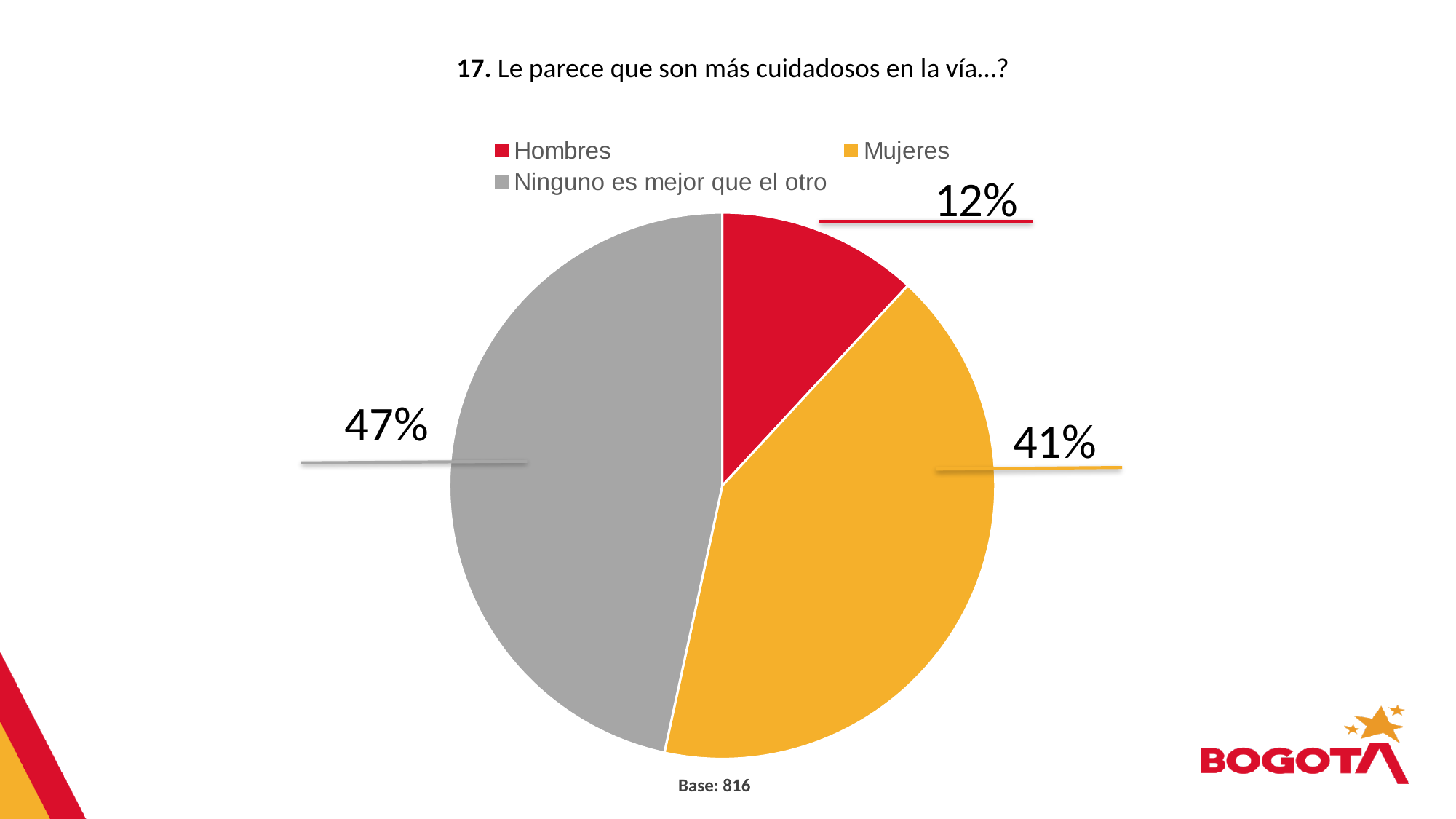
What kind of chart is shown on the slide? pie chart What is the difference in percentage points between "Ninguno es mejor que el otro" and "Mujeres"? 6 What colour is the slice for "Mujeres"? yellow/orange Which category has the smallest share of the pie? Hombres What is the difference in percentage points between "Mujeres" and "Hombres"? 29 Which category has the largest share of the pie? Ninguno es mejor que el otro How many slices does the pie chart have? 3 Which is larger, the share for "Mujeres" or the share for "Hombres"? Mujeres What percentage of respondents answered "Mujeres"? 41% How many entries does the legend list? 3 What percentage of respondents answered "Hombres"? 12% What percentage of respondents answered "Ninguno es mejor que el otro"? 47%